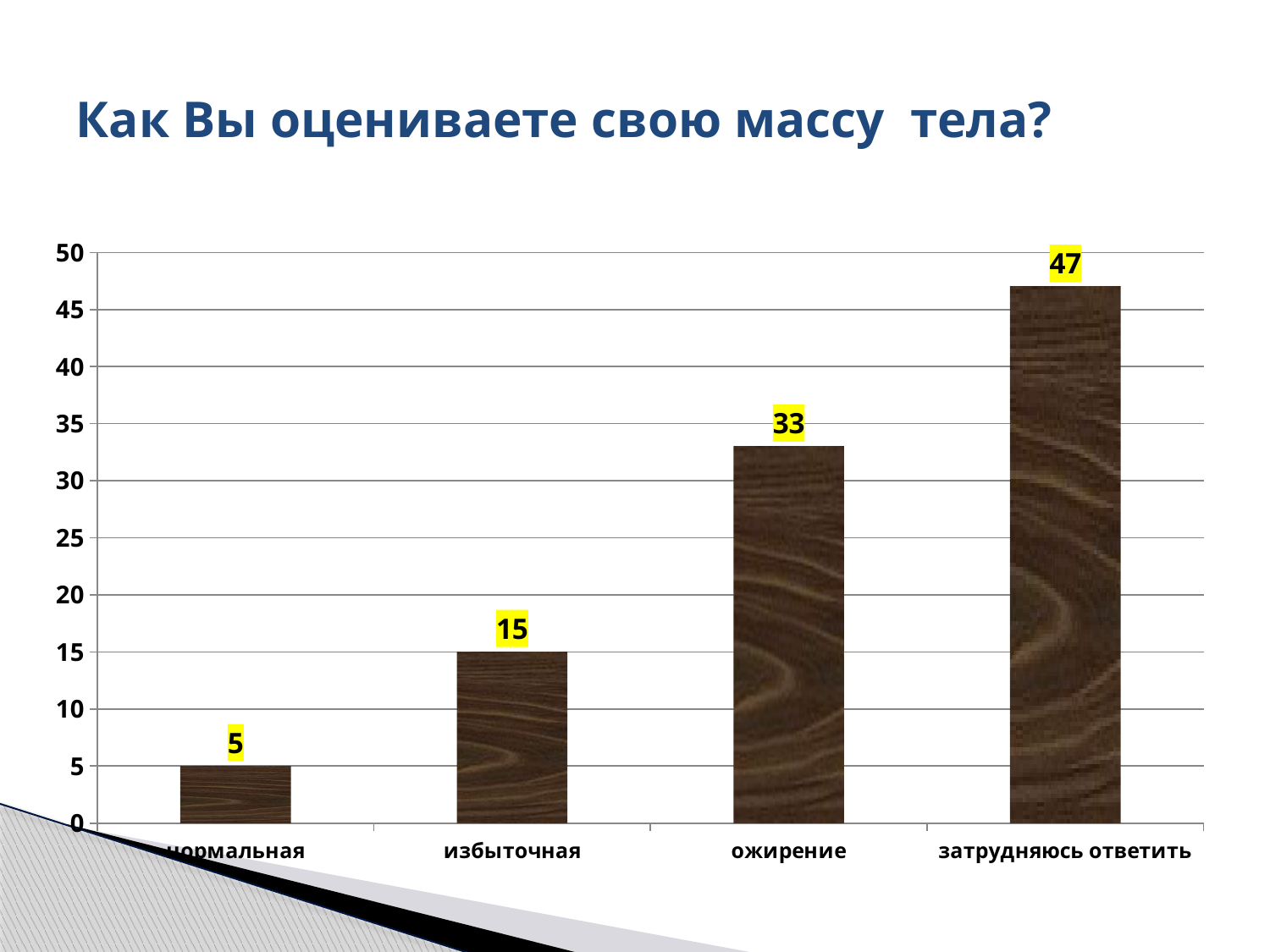
Which is larger, the value for "ожирение" or the value for "избыточная"? ожирение Which category has the lowest value? нормальная How many categories are shown on the chart? 4 What is the value for "нормальная"? 5 What is the title of the slide? Как Вы оцениваете свою массу тела? Which category has the highest value? затрудняюсь ответить What kind of chart is shown on the slide? bar chart What is the value for "избыточная"? 15 What is the value for "затрудняюсь ответить"? 47 What is the difference between the values for "затрудняюсь ответить" and "ожирение"? 14 What is the difference between the values for "избыточная" and "нормальная"? 10 What is the value for "ожирение"? 33